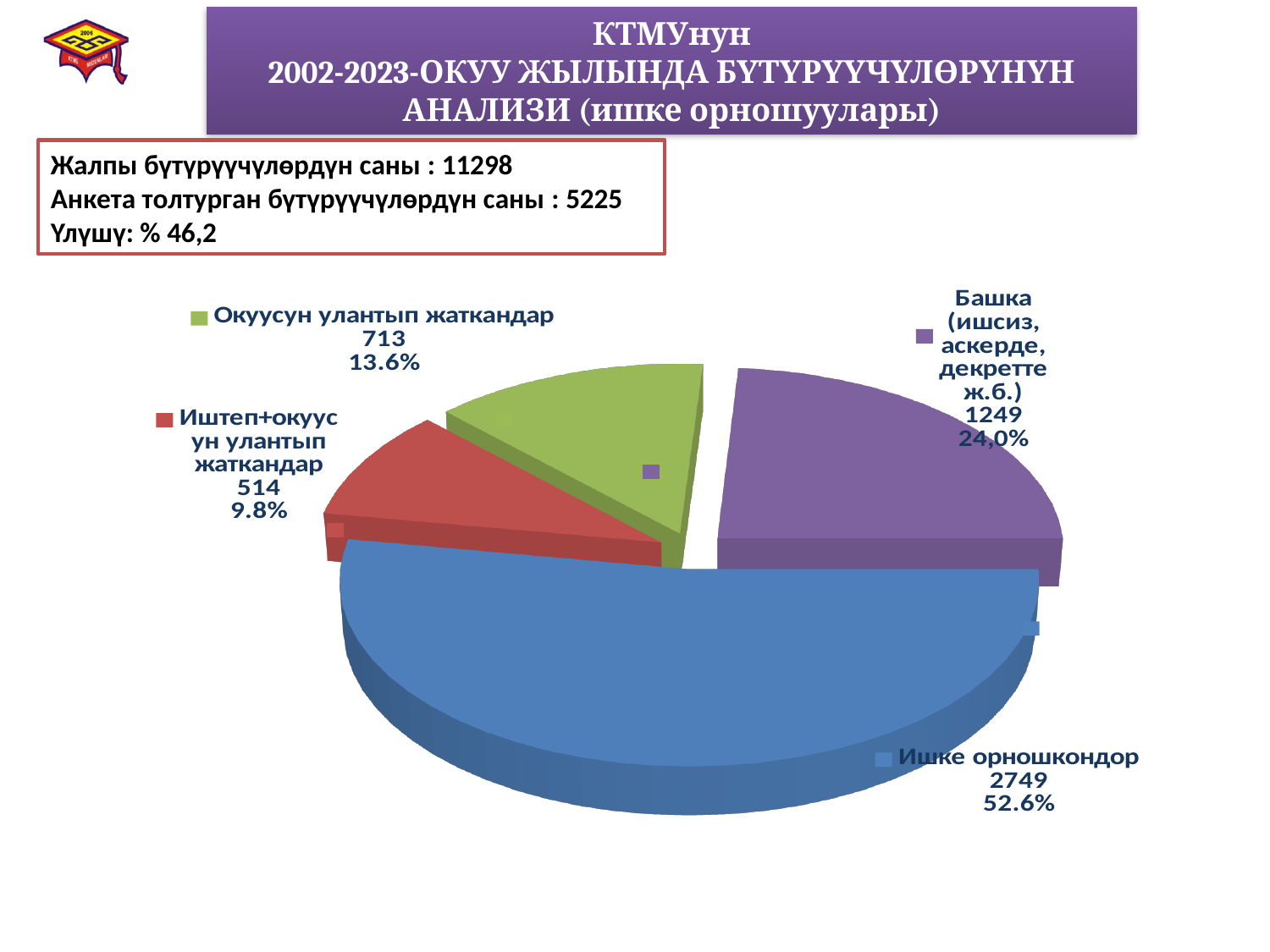
Which category has the largest slice? Ишке орношкондор What kind of chart is shown on the slide? pie chart What is the value for Окуусун улантып жаткандар? 713 What is the value for Иштеп+окуусун улантып жаткандар? 514 What is the difference between the values for Ишке орношкондор and Башка (ишсиз, аскерде, декретте ж.б.)? 1500 Which category has the smallest slice? Иштеп+окуусун улантып жаткандар What share of the pie does Башка (ишсиз, аскерде, декретте ж.б.) represent? 24,0% How many slices does the pie chart have? 4 Which is larger, the value for Окуусун улантып жаткандар or the value for Иштеп+окуусун улантып жаткандар? Окуусун улантып жаткандар What is the value for Ишке орношкондор? 2749 What is the value for Башка (ишсиз, аскерде, декретте ж.б.)? 1249 What share of the pie does Ишке орношкондор represent? 52.6%